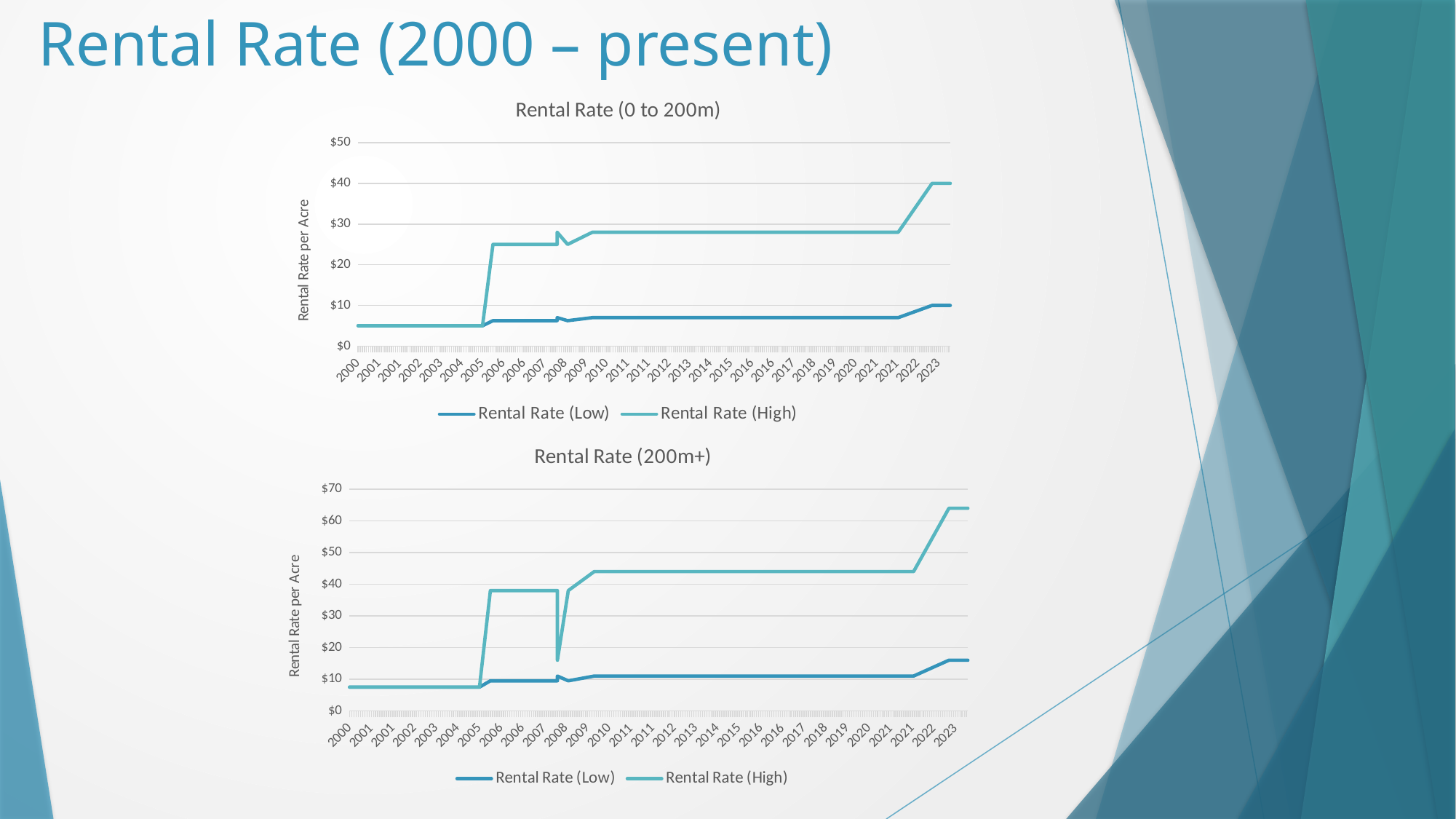
What is the y-axis title of the bottom chart, 'Rental Rate (200m+)'? Rental Rate per Acre How many series does the legend of the bottom chart, 'Rental Rate (200m+)', list? 2 In the top chart, 'Rental Rate (0 to 200m)', does the Rental Rate (High) series generally rise or fall from 2000 to 2023? Rise What are the two series named in the legend of the top chart, 'Rental Rate (0 to 200m)'? Rental Rate (Low) and Rental Rate (High) In the top chart, 'Rental Rate (0 to 200m)', what is the Rental Rate (High) value in 2023? $40 In the bottom chart, 'Rental Rate (200m+)', is the Rental Rate (High) value in 2000 greater or less than $10? less In the bottom chart, 'Rental Rate (200m+)', is the Rental Rate (High) value in 2023 greater or less than $60? greater What kind of chart is the top chart, 'Rental Rate (0 to 200m)'? Line chart In the bottom chart, 'Rental Rate (200m+)', which series is higher in 2023, Rental Rate (Low) or Rental Rate (High)? Rental Rate (High) In the top chart, 'Rental Rate (0 to 200m)', is the Rental Rate (High) value in 2015 greater or less than $30? less In the top chart, 'Rental Rate (0 to 200m)', what is the Rental Rate (Low) value in 2023? $10